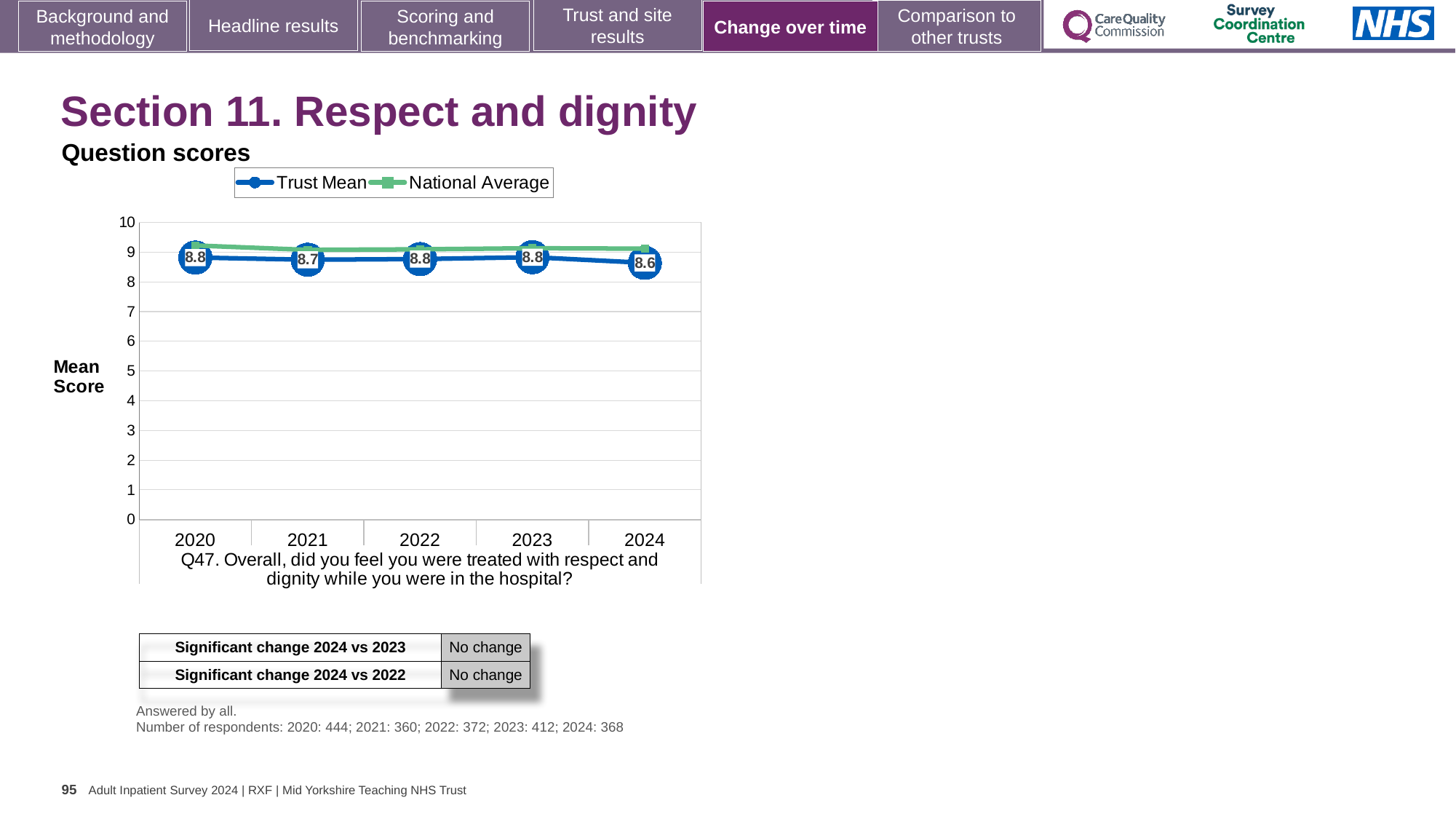
Does the Trust Mean score rise or fall from 2023 to 2024? Fall Which year has the higher Trust Mean score, 2021 or 2024? 2021 What kind of chart is shown on the slide? Line chart How many series does the chart legend list? 2 What is the Trust Mean score for 2021? 8.7 Is the National Average value for 2020 greater or less than 8? greater How many years are shown on the x axis of the chart? 5 What is the difference between the Trust Mean scores for 2023 and 2024? 0.2 What is the Trust Mean score for 2020? 8.8 What is the Trust Mean score for 2024? 8.6 In which year is the Trust Mean score lowest? 2024 In 2024, which series has the higher value, Trust Mean or National Average? National Average